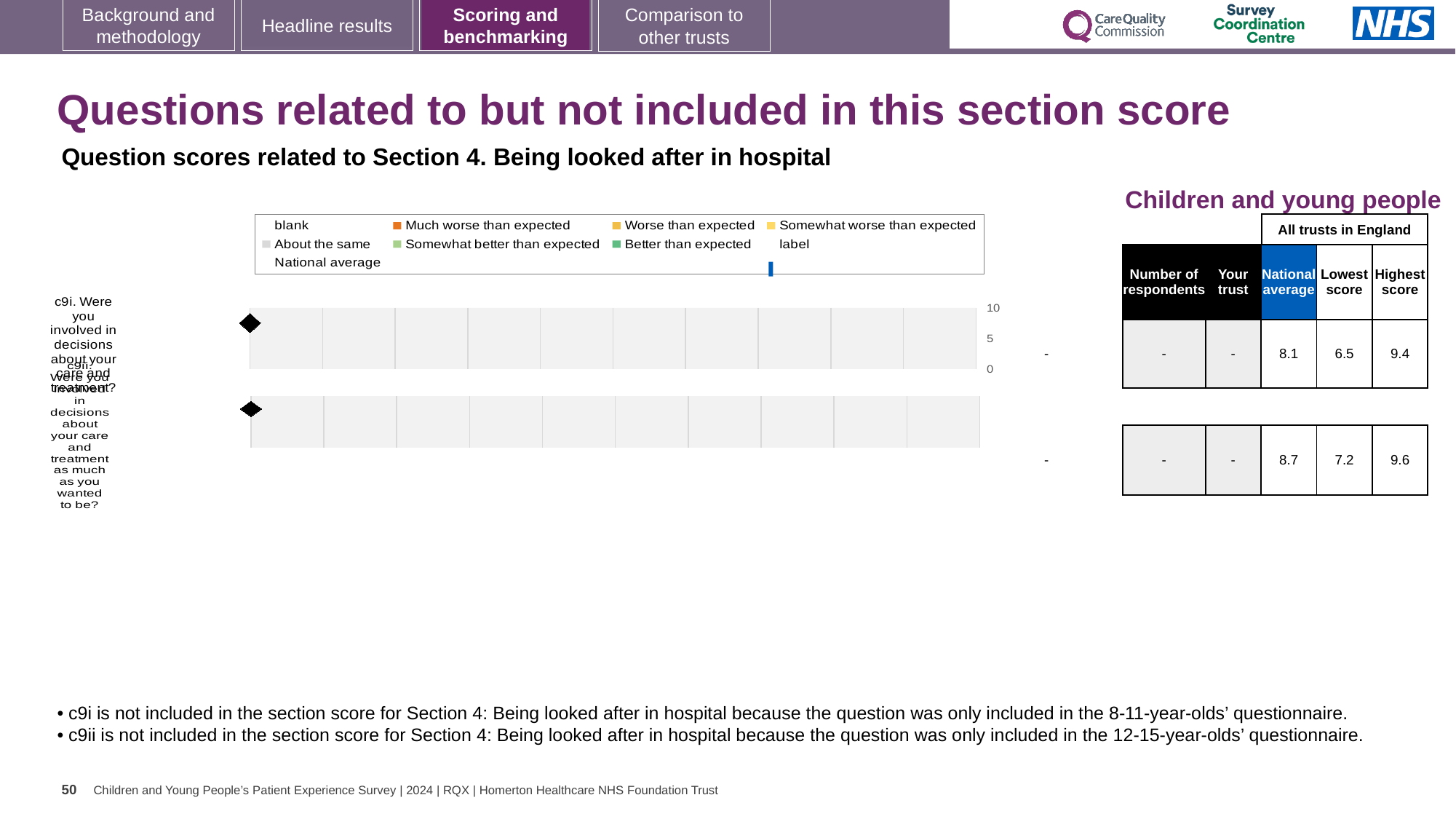
In the table to the right of the chart, which question has the higher national average, c9i or c9ii? c9ii In the table to the right of the chart, what is the national average for c9ii? 8.7 In the table to the right of the chart, what is the lowest score for c9i? 6.5 What colour does the legend use for 'Much worse than expected'? orange What kind of chart is shown on the slide? bar chart In the table to the right of the chart, what is the difference between the highest score and the lowest score for c9ii? 2.4 What is the highest value shown on the chart's numeric axis? 10 How many question categories are plotted on the chart? 2 In the table to the right of the chart, what is the difference between the highest score and the lowest score for c9i? 2.9 In the table to the right of the chart, what is shown in the 'Your trust' column for c9i? - In the table to the right of the chart, what is the national average for c9i? 8.1 In the table to the right of the chart, what is the highest score for c9ii? 9.6